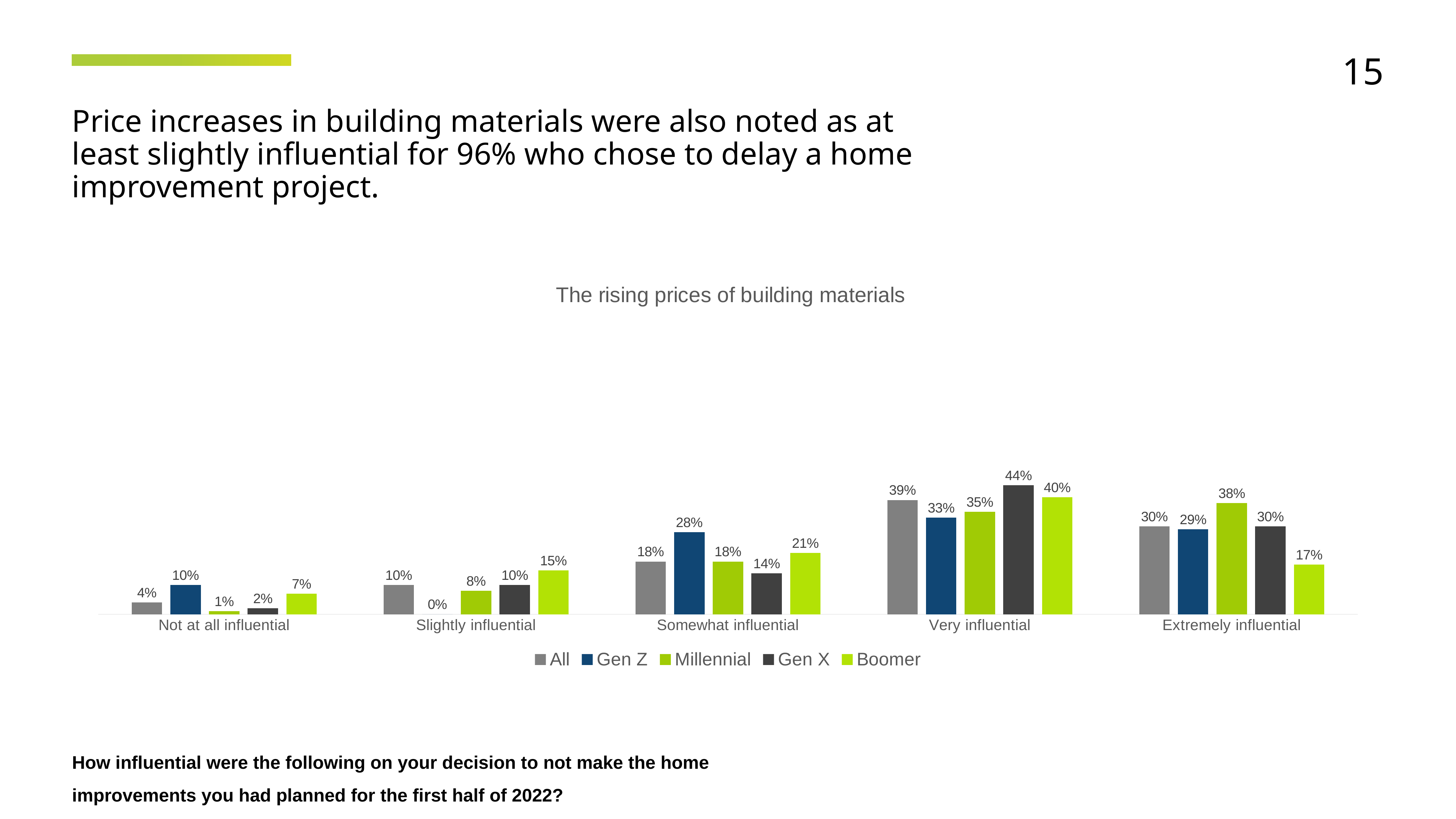
What is the value for All in the Somewhat influential category? 18% How many series does the legend list? 5 Which series has the highest value in the Somewhat influential category? Gen Z How many categories are shown on the x axis? 5 What is the value for Boomer in the Extremely influential category? 17% Which series has the lowest value in the Not at all influential category? Millennial What is the difference between the Gen X and Gen Z values in the Very influential category? 11% Which is larger in the Extremely influential category: Millennial or Boomer? Millennial What is the title of the chart? The rising prices of building materials What is the value for Gen X in the Very influential category? 44% What kind of chart is shown on the slide? Bar chart What is the value for Gen Z in the Slightly influential category? 0%